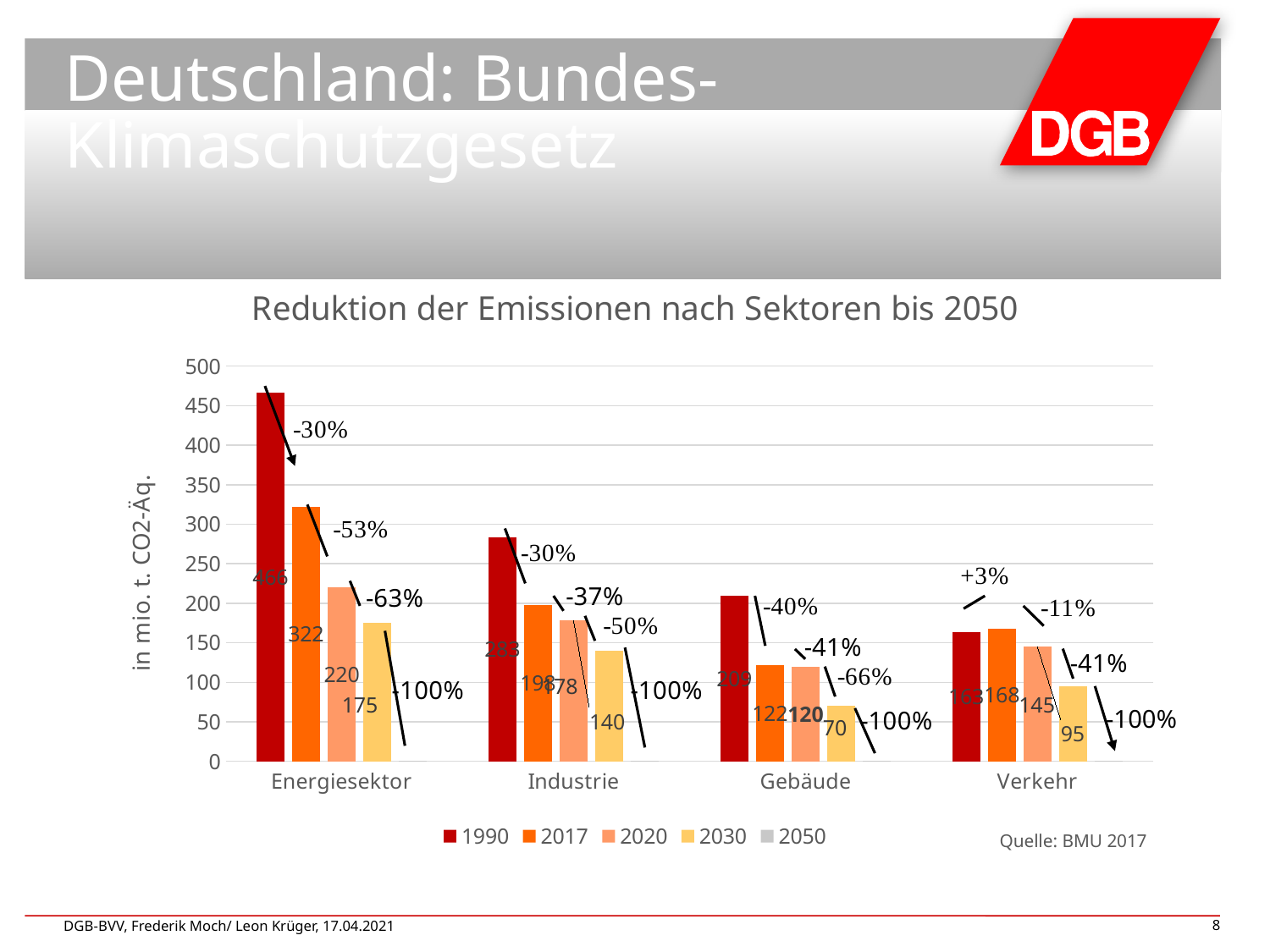
What is the difference between the 1990 and 2030 values for Energiesektor? 291 What is the 2030 value for Energiesektor? 175 How many sectors are shown on the x axis? 4 What is the 2030 value for Gebäude? 70 For Verkehr, which is larger: the 1990 value or the 2017 value? 2017 What is the 2030 value for Industrie? 140 What is the label of the y axis? in mio. t. CO2-Äq. What is the 2030 value for Verkehr? 95 What is the 2017 value for Energiesektor? 322 What kind of chart is shown on the slide? bar chart Which sector has the highest 1990 value? Energiesektor How many series does the legend list? 5